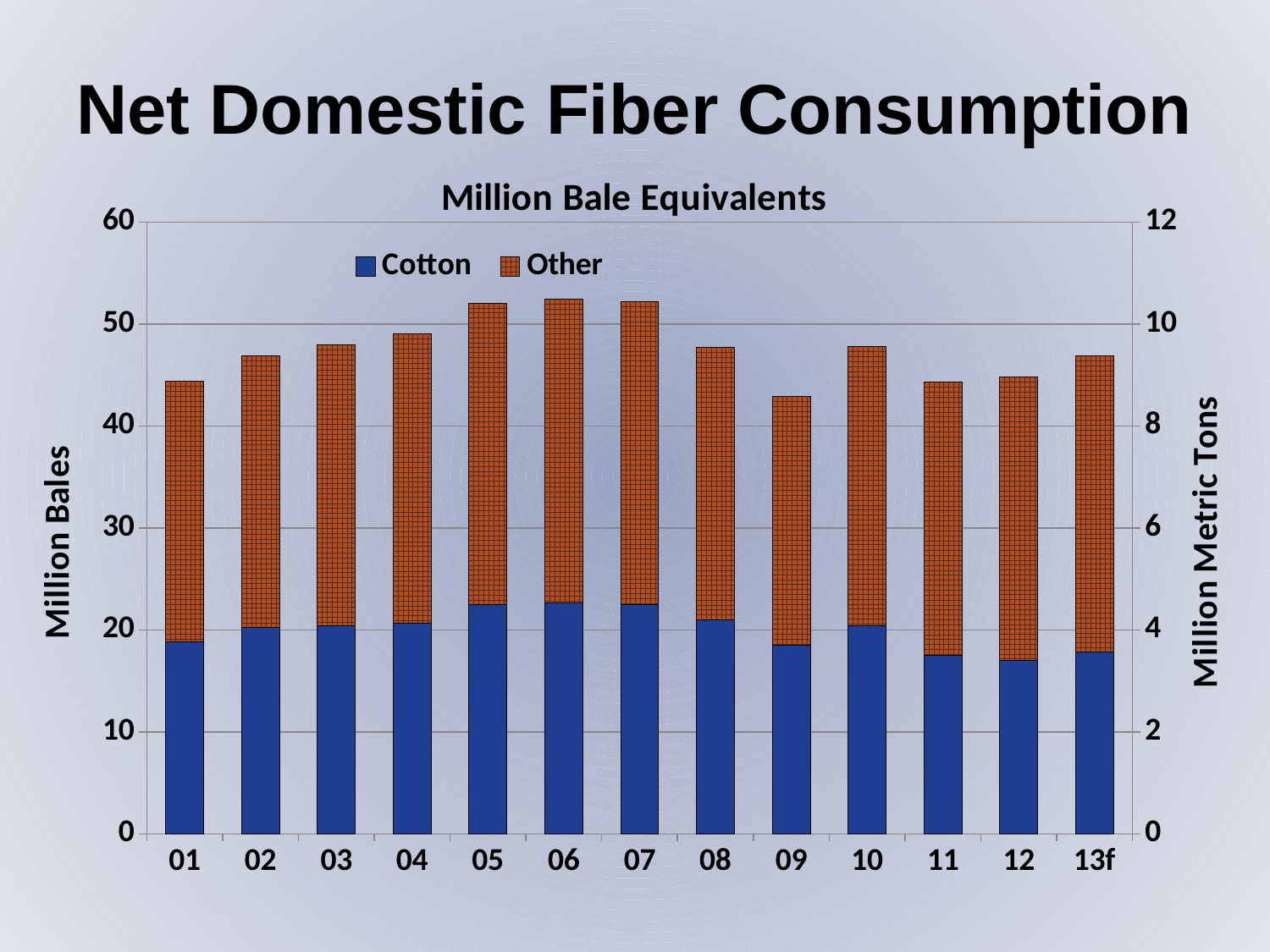
Is the total bar for 09 greater or less than 50 million bales? less Which is larger, the total bar for 05 or the total bar for 09? 05 What is the title of the right-hand vertical axis? Million Metric Tons Is the Cotton value for 01 greater or less than 20 million bales? less How many years (categories) are shown on the x axis? 13 Do the total bars rise or fall from 01 to 06? rise Which year has the lowest total fiber consumption? 09 How many series does the legend list? 2 Is the total bar for 06 greater or less than 50 million bales? greater What kind of chart is shown on the slide? Stacked bar chart Which is larger, the Cotton value for 06 or the Cotton value for 12? 06